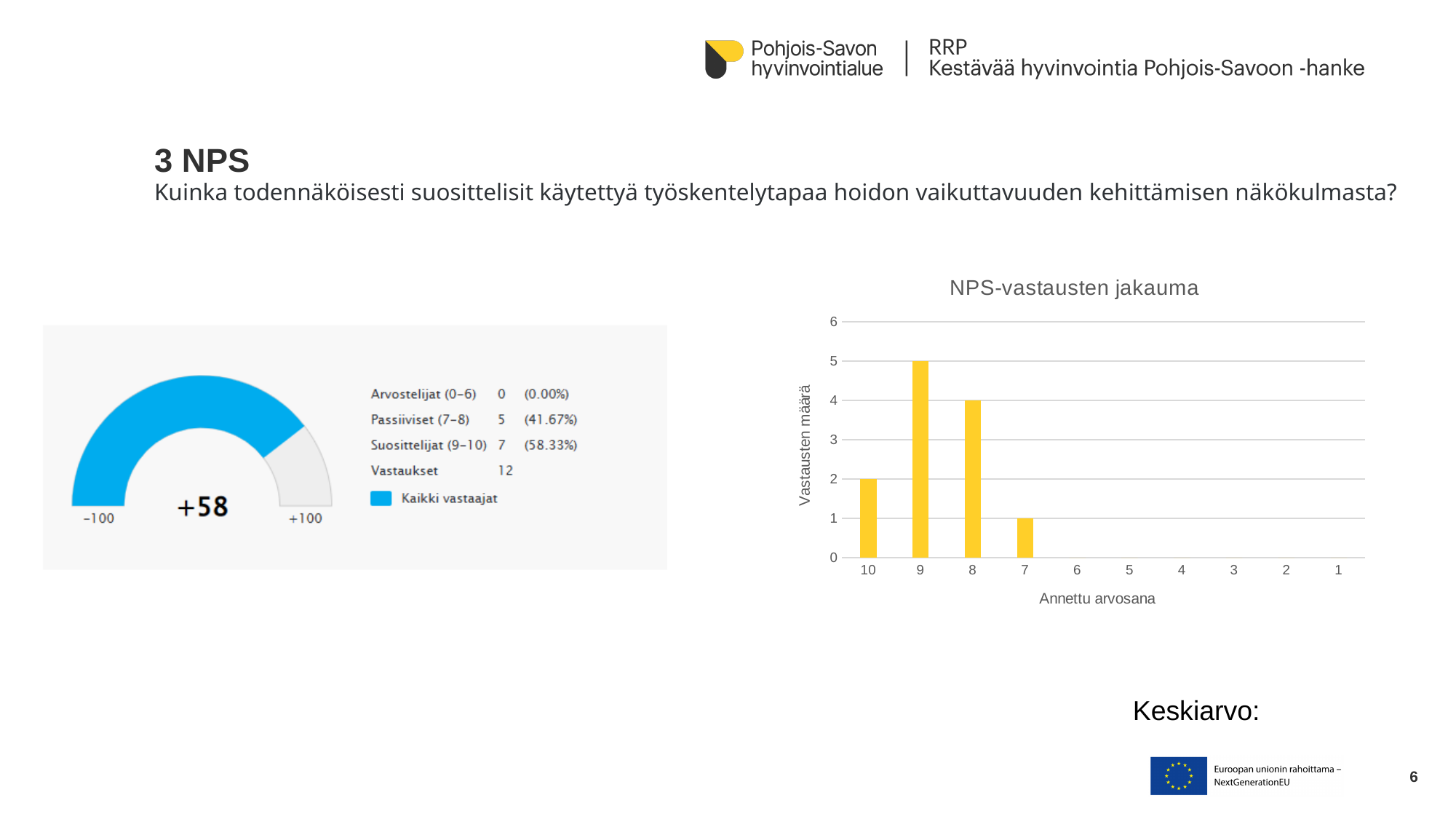
In the 'NPS-vastausten jakauma' chart, how many score categories are shown on the x axis? 10 In the 'NPS-vastausten jakauma' chart, which score has more responses, 8 or 10? 8 In the 'NPS-vastausten jakauma' chart, how many responses gave a score of 9? 5 In the gauge chart on the left, what is the total number of responses (Vastaukset)? 12 In the 'NPS-vastausten jakauma' chart, which score received the most responses? 9 In the 'NPS-vastausten jakauma' chart, what kind of chart is shown? bar chart In the 'NPS-vastausten jakauma' chart, how many responses gave a score of 8? 4 In the 'NPS-vastausten jakauma' chart, what is the difference between the number of responses for score 9 and score 7? 4 In the 'NPS-vastausten jakauma' chart, how many responses gave a score of 7? 1 In the 'NPS-vastausten jakauma' chart, what is the label of the y axis? Vastausten määrä In the 'NPS-vastausten jakauma' chart, how many responses gave a score of 10? 2 In the gauge chart on the left, what NPS value is shown? +58